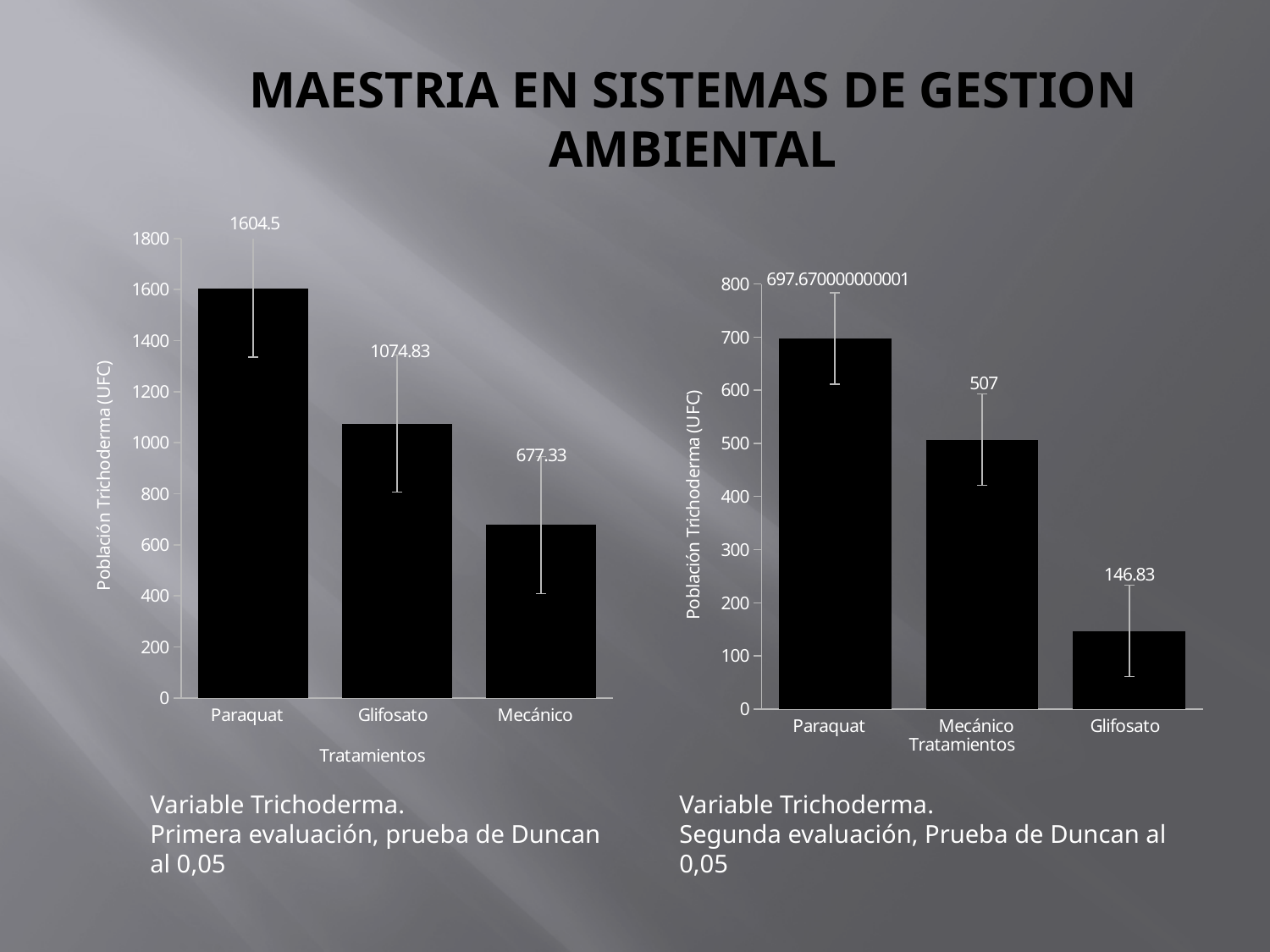
In the left chart (Primera evaluación), what is the difference between the values for Paraquat and Glifosato? 529.67 In the left chart (Primera evaluación), what is the value for Glifosato? 1074.83 How many treatments are shown in the right chart (Segunda evaluación)? 3 What kind of chart is the left chart (Primera evaluación)? Bar chart In the right chart (Segunda evaluación), which is larger, the value for Mecánico or the value for Glifosato? Mecánico In the right chart (Segunda evaluación), what is the value for Glifosato? 146.83 In the left chart (Primera evaluación), what is the value for Mecánico? 677.33 In the left chart (Primera evaluación), what is the value for Paraquat? 1604.5 In the left chart (Primera evaluación), which treatment has the highest value? Paraquat In the right chart (Segunda evaluación), what is the value for Mecánico? 507 In the right chart (Segunda evaluación), which treatment has the lowest value? Glifosato What is the y-axis label of the right chart (Segunda evaluación)? Población Trichoderma (UFC)